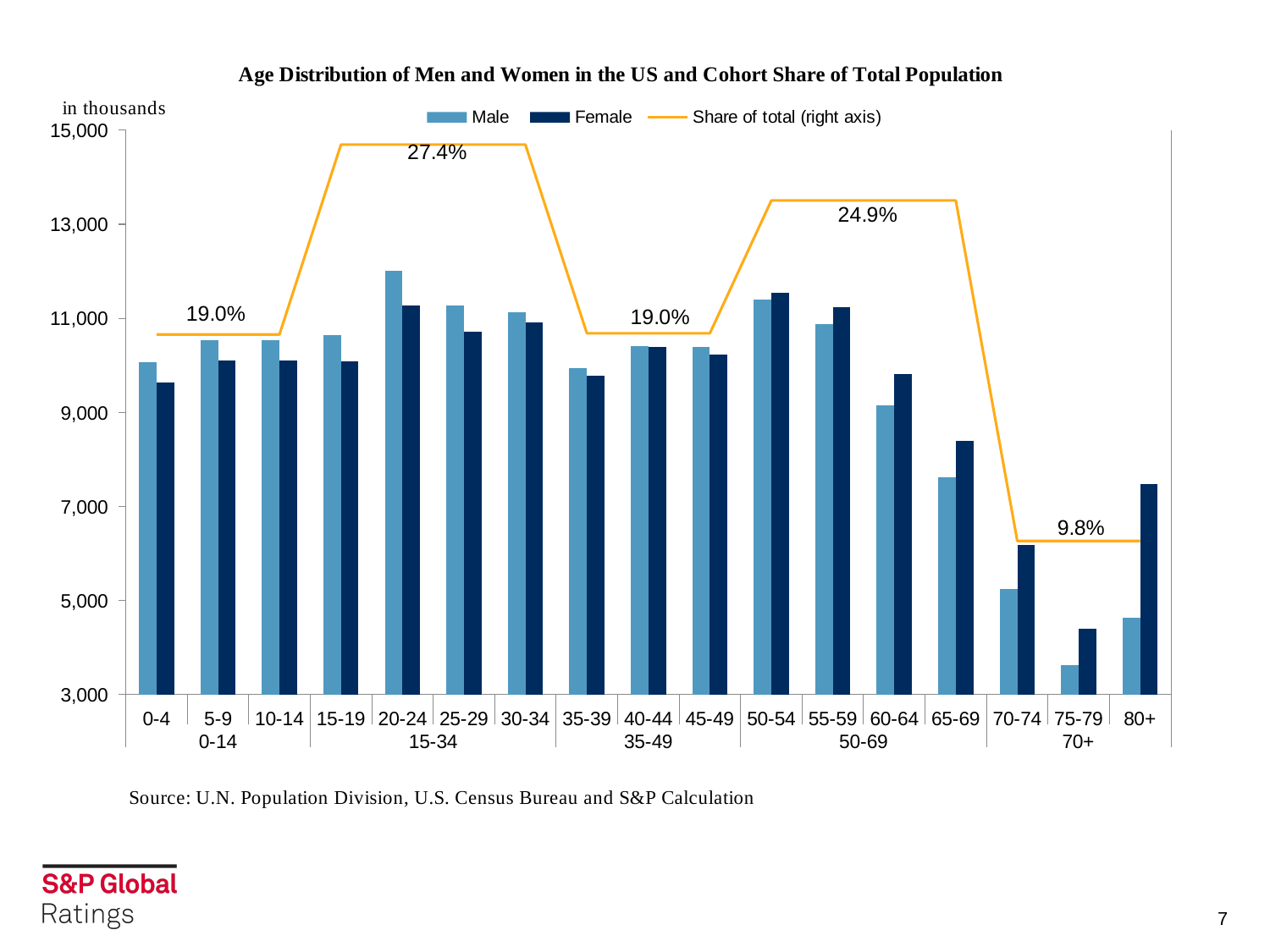
Which cohort has the lowest share of total population? 70+ How many series does the legend list? 3 Which cohort has the highest share of total population? 15-34 What is the difference between the share of total for the 15-34 cohort and the 50-69 cohort? 2.5 percentage points What is the share of total population for the 50-69 cohort? 24.9% How many five-year age groups are shown on the x axis? 17 What is the share of total population for the 15-34 cohort? 27.4% What is the share of total population for the 70+ cohort? 9.8% For the 80+ age group, which is larger, the Male or the Female value? Female What kind of chart is shown on the slide? bar chart with a line Is the Male value for the 20-24 age group greater or less than 11,000? greater Is the Female value for the 75-79 age group greater or less than 5,000? less